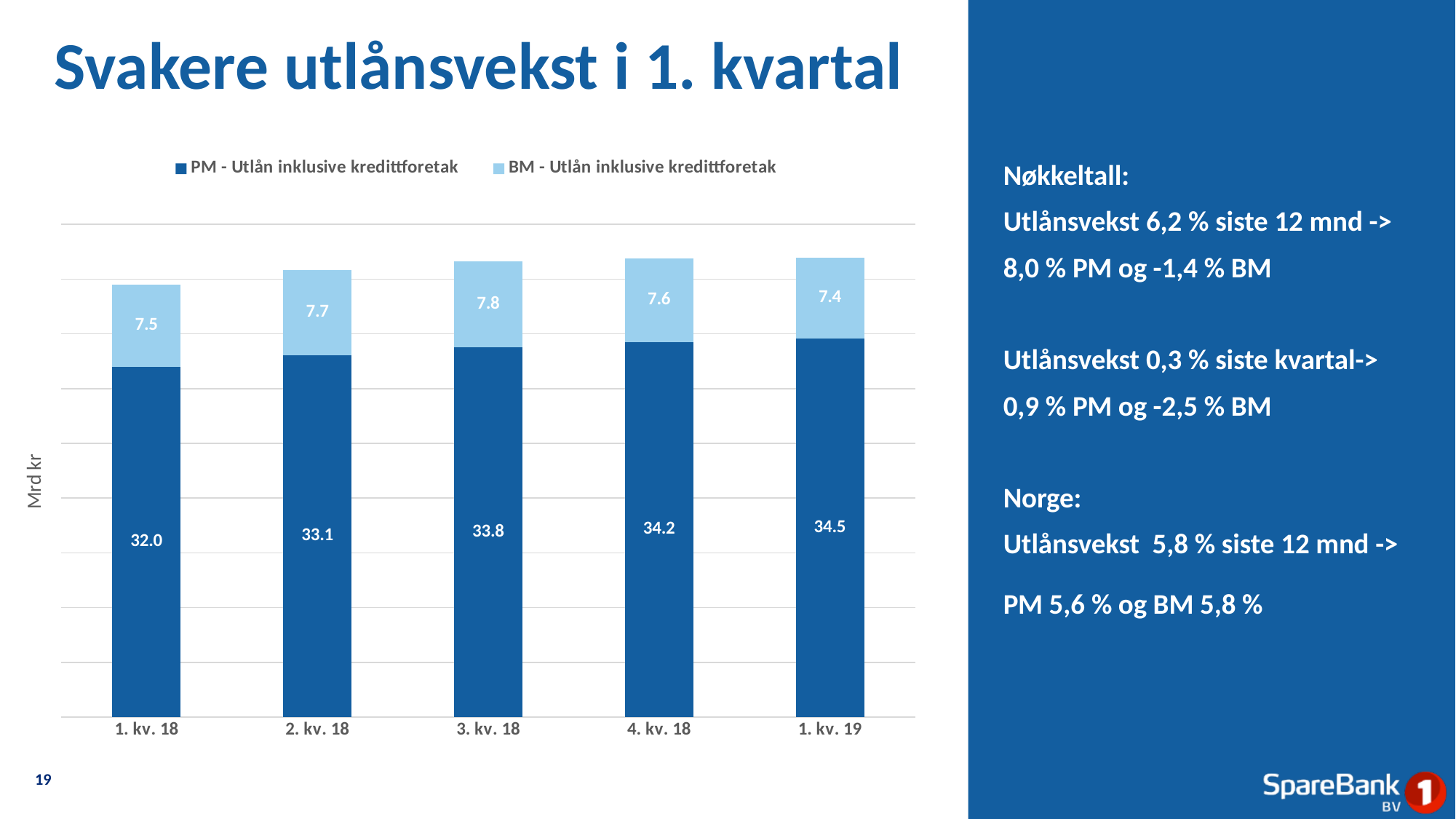
Which quarter has the lowest BM - Utlån inklusive kredittforetak value? 1. kv. 19 What is the PM - Utlån inklusive kredittforetak value for 1. kv. 19? 34.5 What is the difference between the PM values for 1. kv. 19 and 1. kv. 18? 2.5 Do the PM - Utlån inklusive kredittforetak values rise or fall from 1. kv. 18 to 1. kv. 19? Rise What kind of chart is shown on the slide? Stacked bar chart How many series does the legend list? 2 What is the PM - Utlån inklusive kredittforetak value for 1. kv. 18? 32.0 Which is larger, the BM value for 2. kv. 18 or the BM value for 4. kv. 18? 2. kv. 18 How many quarters are shown on the x axis? 5 What is the BM - Utlån inklusive kredittforetak value for 3. kv. 18? 7.8 Which quarter has the highest PM - Utlån inklusive kredittforetak value? 1. kv. 19 What is the total of the stacked bar for 4. kv. 18? 41.8